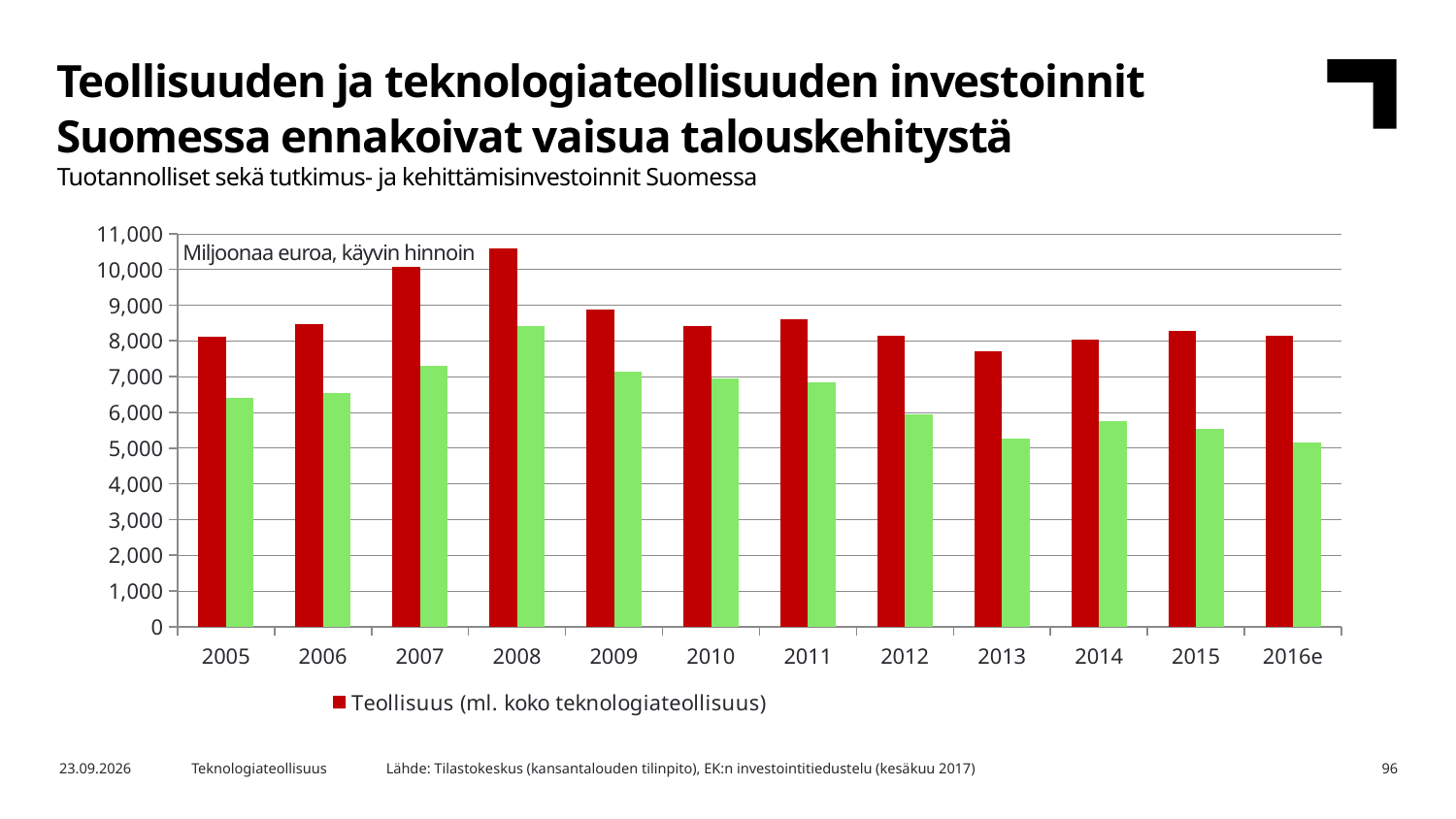
How many years are shown on the x axis of the chart? 12 Is the red Teollisuus value for 2013 greater or less than 8,000? less In which year is the green bar the highest? 2008 How many series does the chart's legend list? 1 In which year is the red Teollisuus bar the highest? 2008 Is the green bar value for 2005 greater or less than 6,000? greater Which is larger: the red Teollisuus bar for 2007 or for 2008? 2008 Which is larger: the green bar for 2013 or for 2014? 2014 What is the series name shown in the chart's legend? Teollisuus (ml. koko teknologiateollisuus) Is the red Teollisuus value for 2008 greater or less than 10,000? greater What kind of chart is shown on the slide? Bar chart What unit label is printed inside the chart's plot area? Miljoonaa euroa, käyvin hinnoin